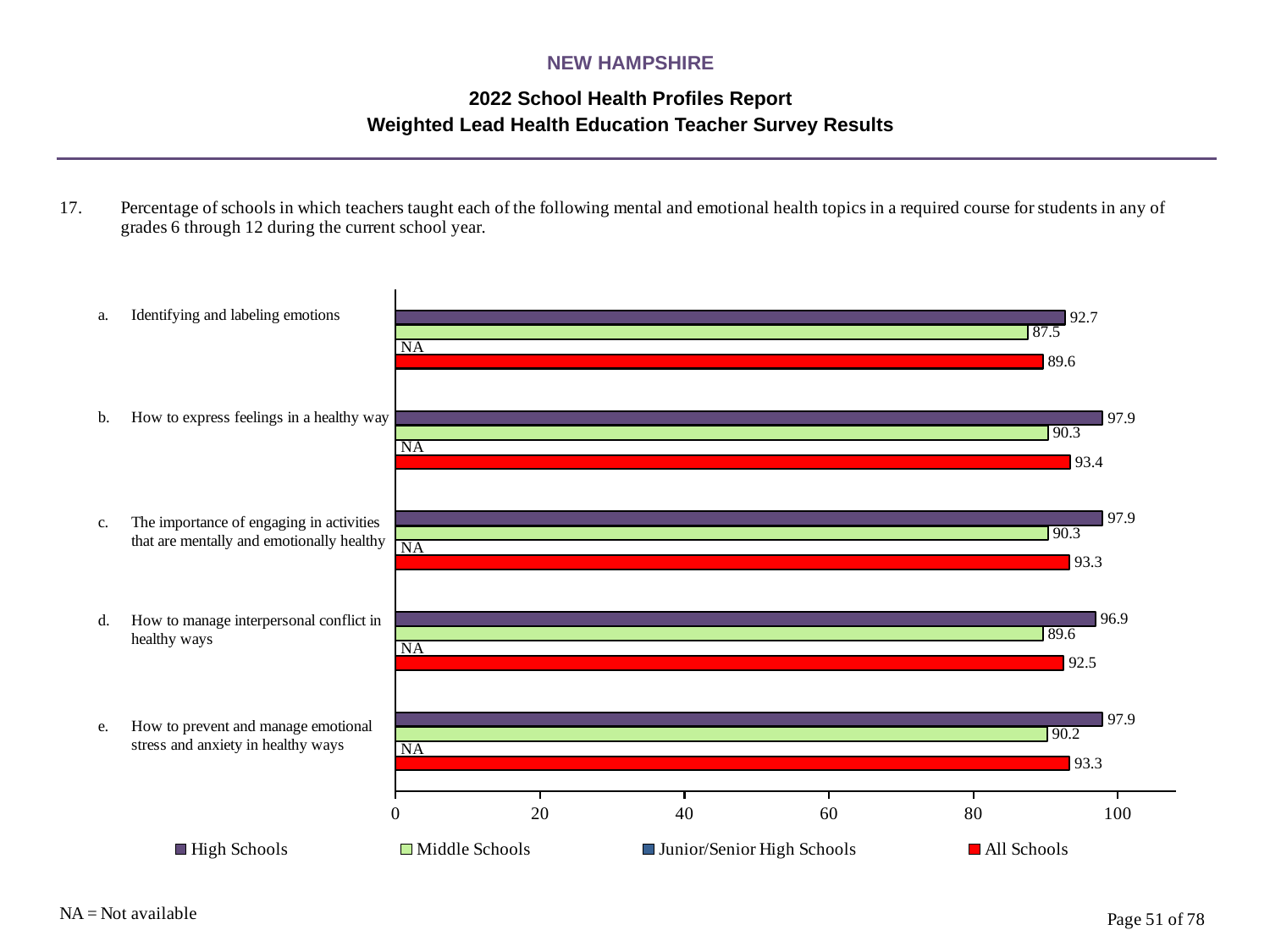
Which topic has the lowest All Schools value? Identifying and labeling emotions What is the High Schools value for "Identifying and labeling emotions"? 92.7 What type of chart is shown on the slide? Bar chart What is the Middle Schools value for "How to manage interpersonal conflict in healthy ways"? 89.6 How many series does the legend list? 4 Which is larger for "How to prevent and manage emotional stress and anxiety in healthy ways": the High Schools value or the All Schools value? High Schools What is the difference between the High Schools and Middle Schools values for "How to express feelings in a healthy way"? 7.6 What does NA stand for according to the note on the slide? Not available How many topics (categories) are shown on the chart? 5 What value is shown for Junior/Senior High Schools for "Identifying and labeling emotions"? NA What is the All Schools value for "How to express feelings in a healthy way"? 93.4 Which topic has the lowest Middle Schools value? Identifying and labeling emotions